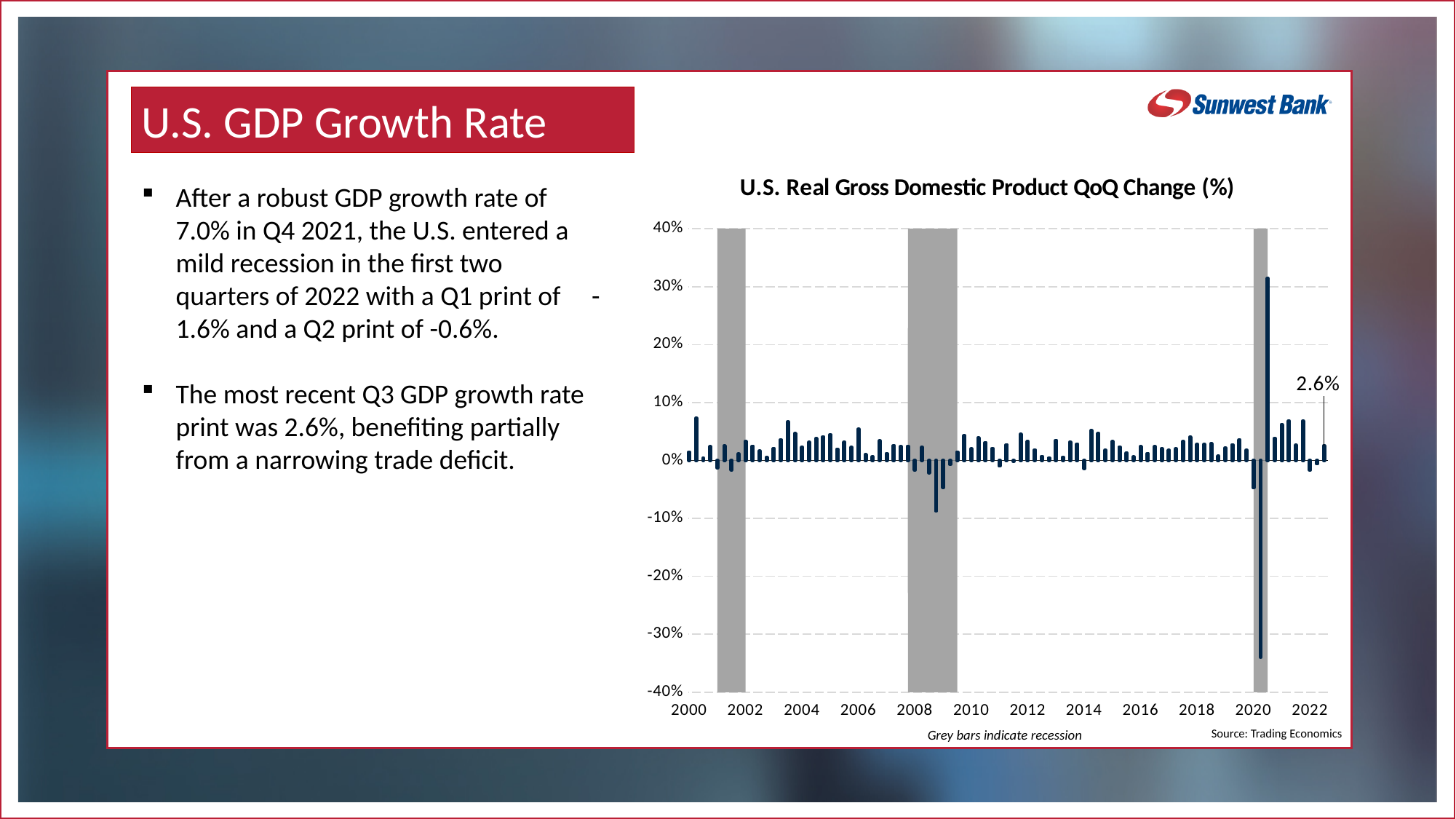
What kind of chart is shown on the slide? Bar chart In which year does the chart's lowest (most negative) bar occur? 2020 Is the tallest positive bar in the chart greater or less than 20%? greater In which year does the chart's tallest positive bar occur? 2020 How many grey recession bands are shown on the chart? 3 Is the lowest bar in the chart greater or less than -30%? less What is the first year labeled on the chart's x-axis? 2000 What is the title of the chart? U.S. Real Gross Domestic Product QoQ Change (%) Is the lowest bar within the 2008-2009 grey recession band greater or less than -5%? less What is the highest value shown on the chart's y-axis? 40% What do the grey bars on the chart indicate? Recession What value is labeled on the most recent bar in the chart? 2.6%